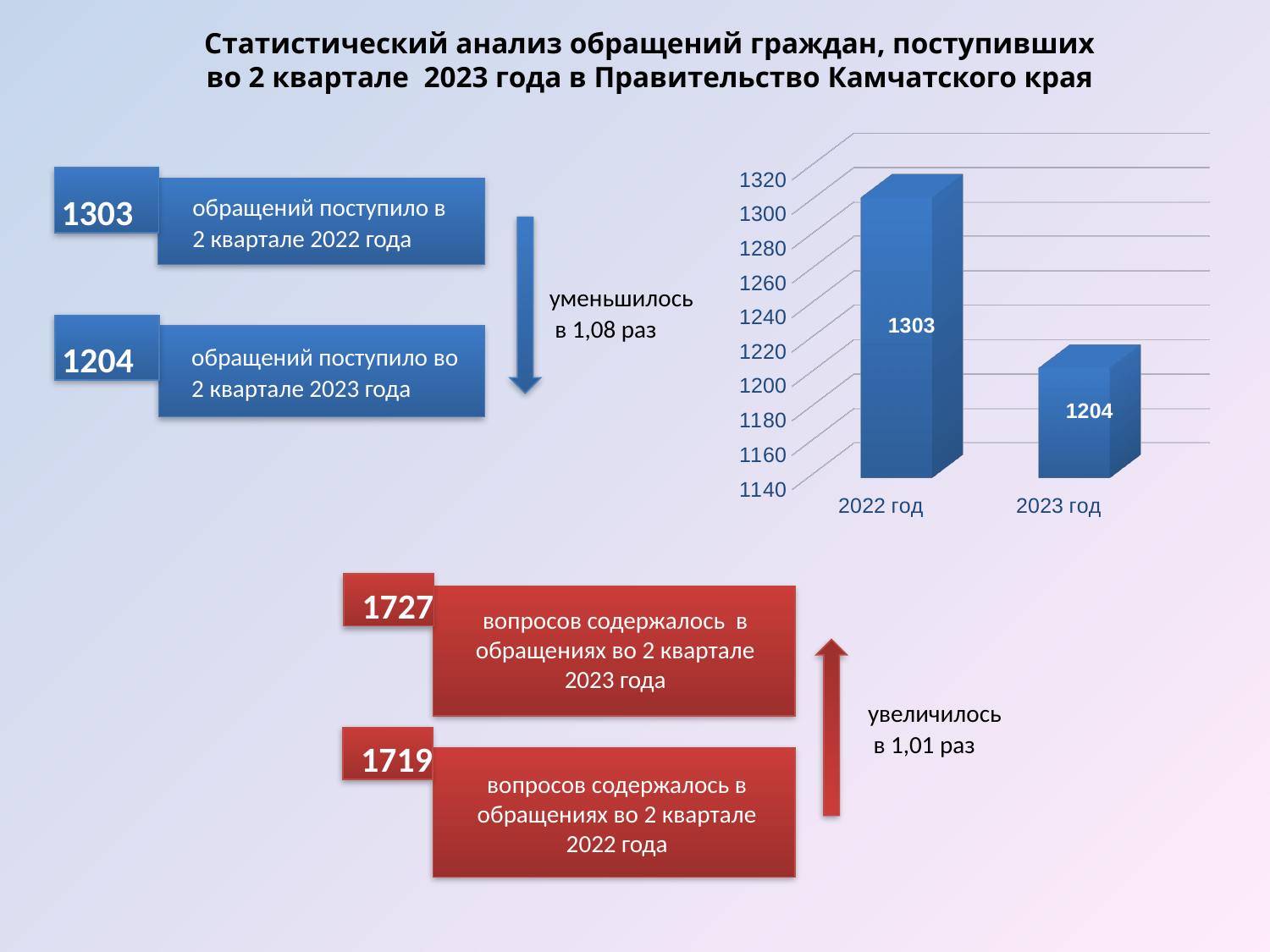
What is the value for 2022 год in the chart? 1303 Is the value for 2023 год greater or less than 1220? less What kind of chart is shown on the slide? bar chart What is the lowest value shown on the vertical axis of the chart? 1140 How many categories are shown on the x axis of the chart? 2 Which year has the lower value in the chart? 2023 год Which year has the higher value in the chart? 2022 год Do the values rise or fall from 2022 год to 2023 год? fall What is the difference between the values for 2022 год and 2023 год? 99 What is the value for 2023 год in the chart? 1204 Is the value for 2022 год greater or less than 1280? greater Is the value for 2022 год larger or smaller than the value for 2023 год? larger